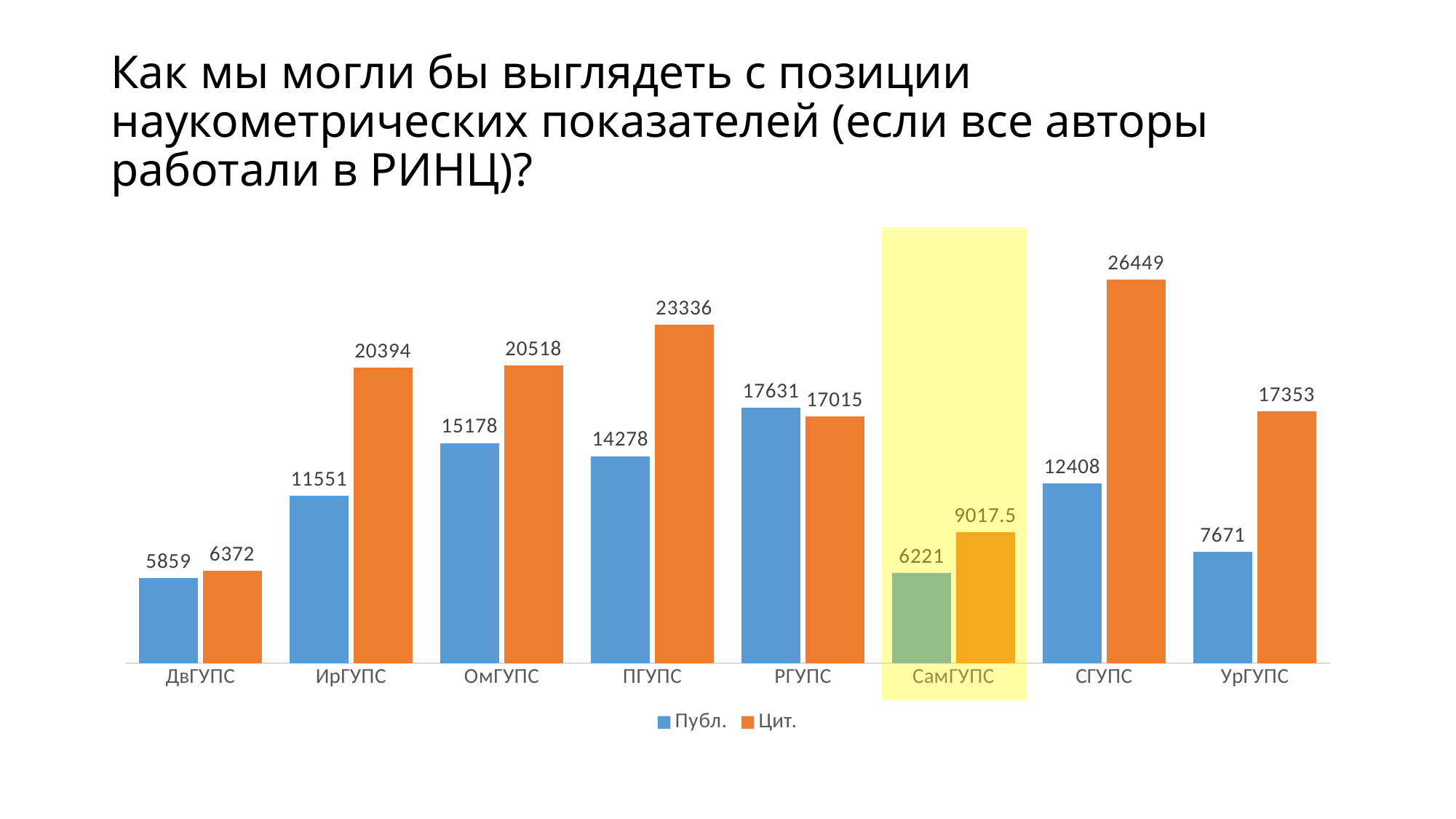
Which is larger for РГУПС, the Публ. value or the Цит. value? Публ. Which category has the lowest Публ. value? ДвГУПС What is the Публ. value for ОмГУПС? 15178 What kind of chart is shown on the slide? bar chart How many series does the legend list? 2 How many categories are shown on the x axis? 8 Which category is highlighted with a yellow background? СамГУПС What is the difference between the Цит. values of СГУПС and ПГУПС? 3113 What is the difference between the Цит. and Публ. values for ИрГУПС? 8843 Which category has the highest Цит. value? СГУПС What is the Цит. value for УрГУПС? 17353 What is the Цит. value for СамГУПС? 9017.5